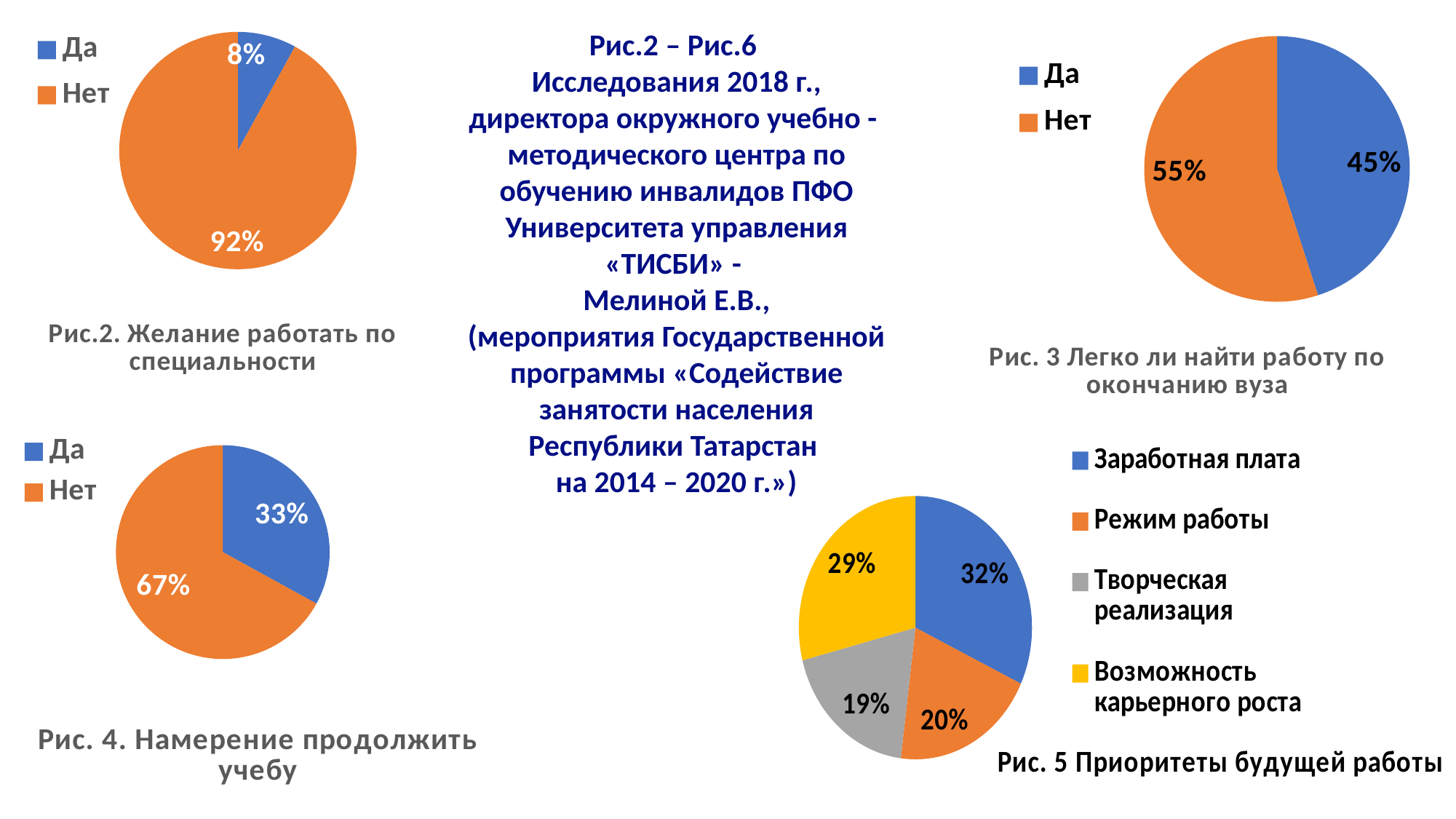
In the chart 'Рис. 4. Намерение продолжить учебу', what is the value for 'Нет'? 67% In the chart 'Рис. 3 Легко ли найти работу по окончанию вуза', what is the value for 'Да'? 45% In the chart 'Рис. 3 Легко ли найти работу по окончанию вуза', which slice is larger, 'Да' or 'Нет'? Нет In the chart 'Рис. 4. Намерение продолжить учебу', what is the difference between 'Нет' and 'Да'? 34% What kind of chart is 'Рис. 5 Приоритеты будущей работы'? Pie chart In the chart 'Рис. 5 Приоритеты будущей работы', how many categories does the legend list? 4 In the chart 'Рис. 5 Приоритеты будущей работы', which category has the highest value? Заработная плата In the chart 'Рис.2. Желание работать по специальности', what share of the pie is 'Да'? 8% In the chart 'Рис. 5 Приоритеты будущей работы', what is the value for 'Творческая реализация'? 19% In the chart 'Рис. 5 Приоритеты будущей работы', which category has the lowest value? Творческая реализация In the chart 'Рис.2. Желание работать по специальности', what share of the pie is 'Нет'? 92% In the chart 'Рис. 5 Приоритеты будущей работы', what colour is the slice for 'Возможность карьерного роста'? Yellow